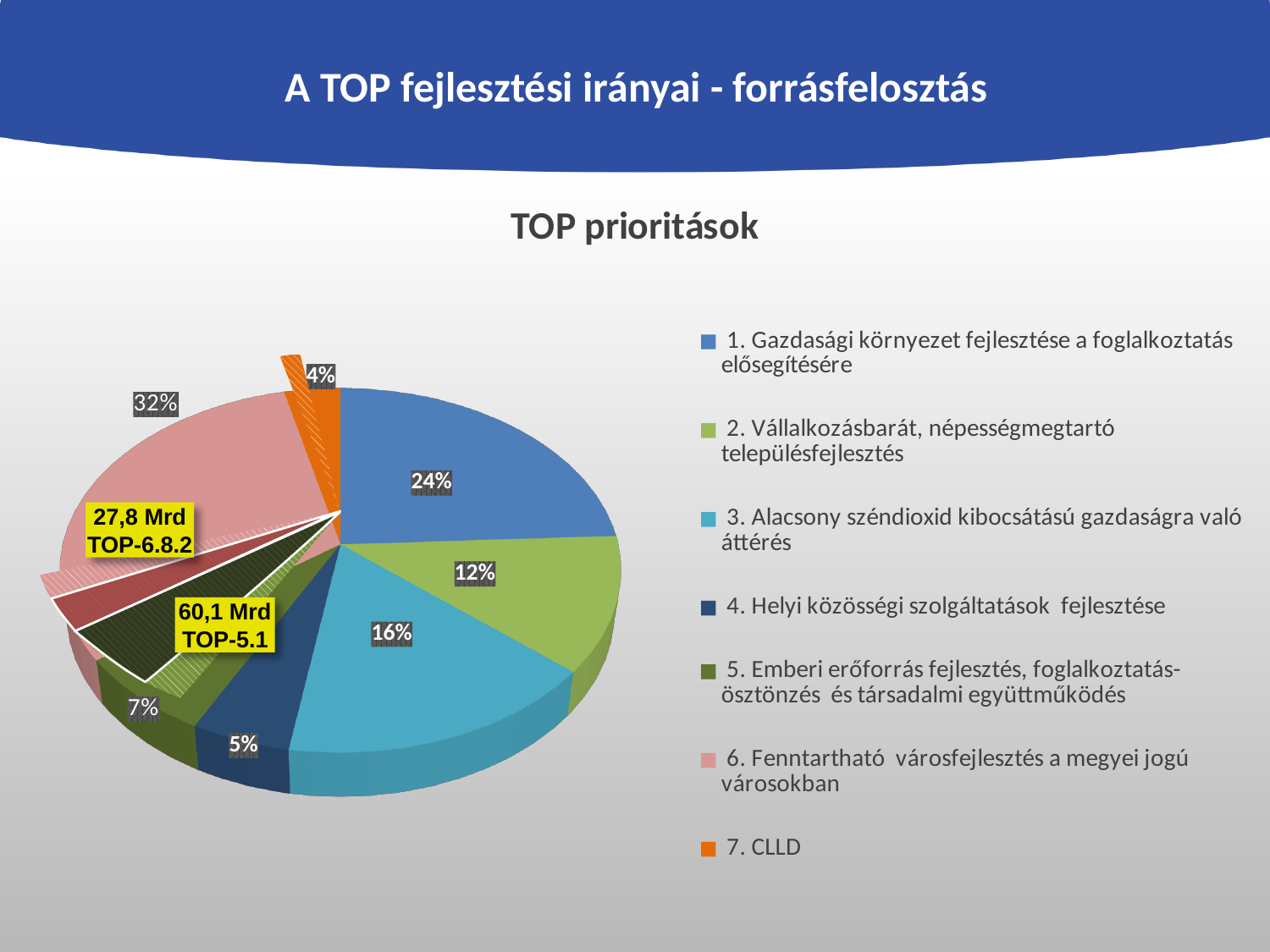
Which priority has the largest share of the pie? 6. Fenntartható városfejlesztés a megyei jogú városokban Which priority has the smallest share of the pie? 7. CLLD What amount is labelled for TOP-5.1 on the chart? 60,1 Mrd What share of the pie does "1. Gazdasági környezet fejlesztése a foglalkoztatás elősegítésére" have? 24% What is the title of the chart? TOP prioritások What share of the pie does "7. CLLD" have? 4% What is the difference in percentage points between the share of priority 6 and the share of priority 1? 8 Which has a larger share: "2. Vállalkozásbarát, népességmegtartó településfejlesztés" or "5. Emberi erőforrás fejlesztés, foglalkoztatás-ösztönzés és társadalmi együttműködés"? 2. Vállalkozásbarát, népességmegtartó településfejlesztés What kind of chart is shown on the slide? pie chart How many slices does the pie chart have? 7 What share of the pie does "3. Alacsony széndioxid kibocsátású gazdaságra való áttérés" have? 16%